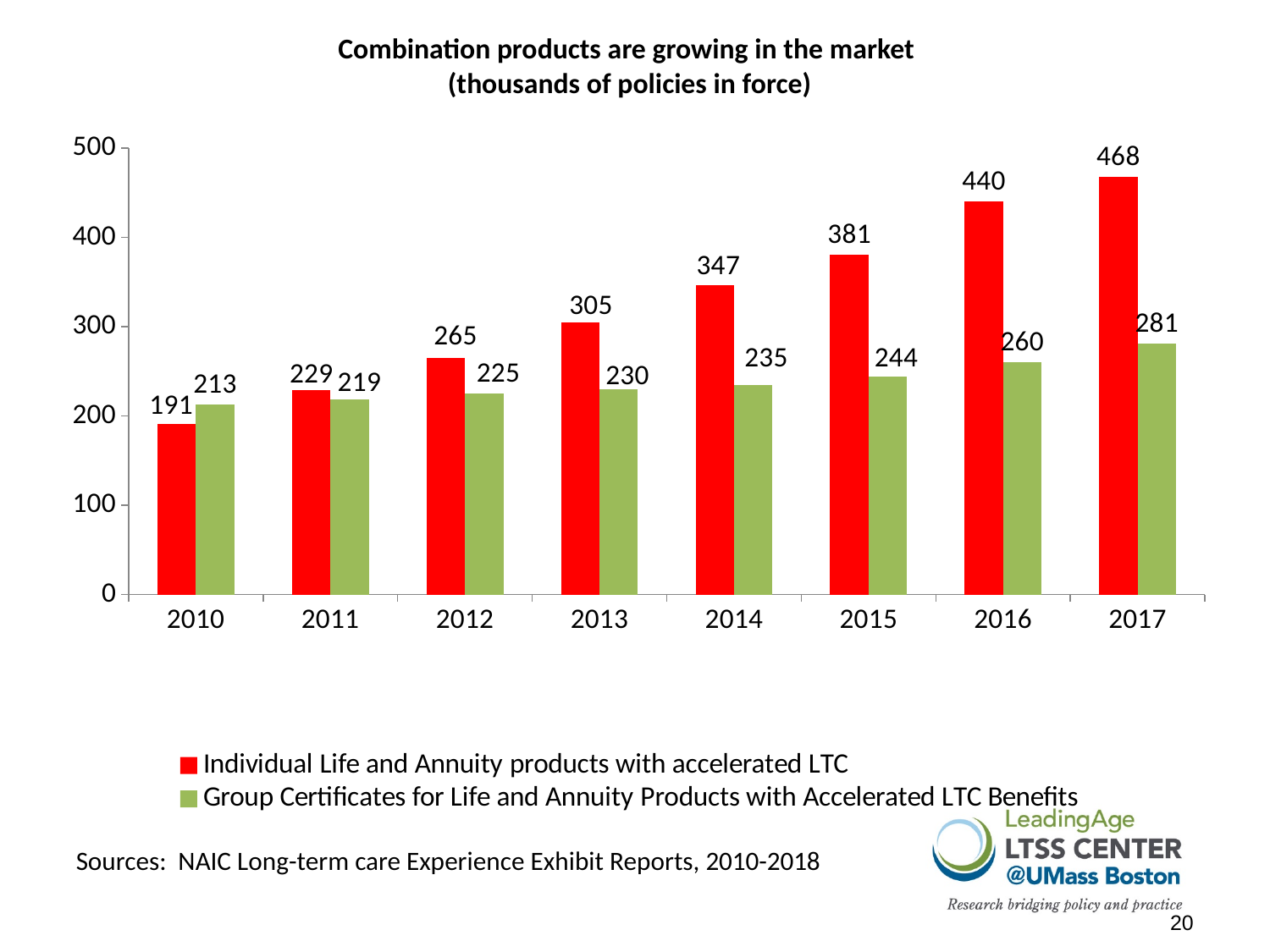
Is the value for Individual Life and Annuity products with accelerated LTC in 2015 greater or less than 400? less In which year is the value for Group Certificates for Life and Annuity Products with Accelerated LTC Benefits lowest? 2010 What is the difference between the Individual Life and Annuity products value and the Group Certificates value in 2017? 187 Do the values for Individual Life and Annuity products with accelerated LTC rise or fall from 2010 to 2017? rise What is the value for Group Certificates for Life and Annuity Products with Accelerated LTC Benefits in 2016? 260 How many series does the legend list? 2 How many years are shown on the x axis? 8 What colour are the bars for Group Certificates for Life and Annuity Products with Accelerated LTC Benefits? green In 2010, which series has the larger value: Individual Life and Annuity products with accelerated LTC or Group Certificates for Life and Annuity Products with Accelerated LTC Benefits? Group Certificates for Life and Annuity Products with Accelerated LTC Benefits What kind of chart is shown on the slide? bar chart What is the value for Individual Life and Annuity products with accelerated LTC in 2014? 347 In which year is the value for Individual Life and Annuity products with accelerated LTC highest? 2017